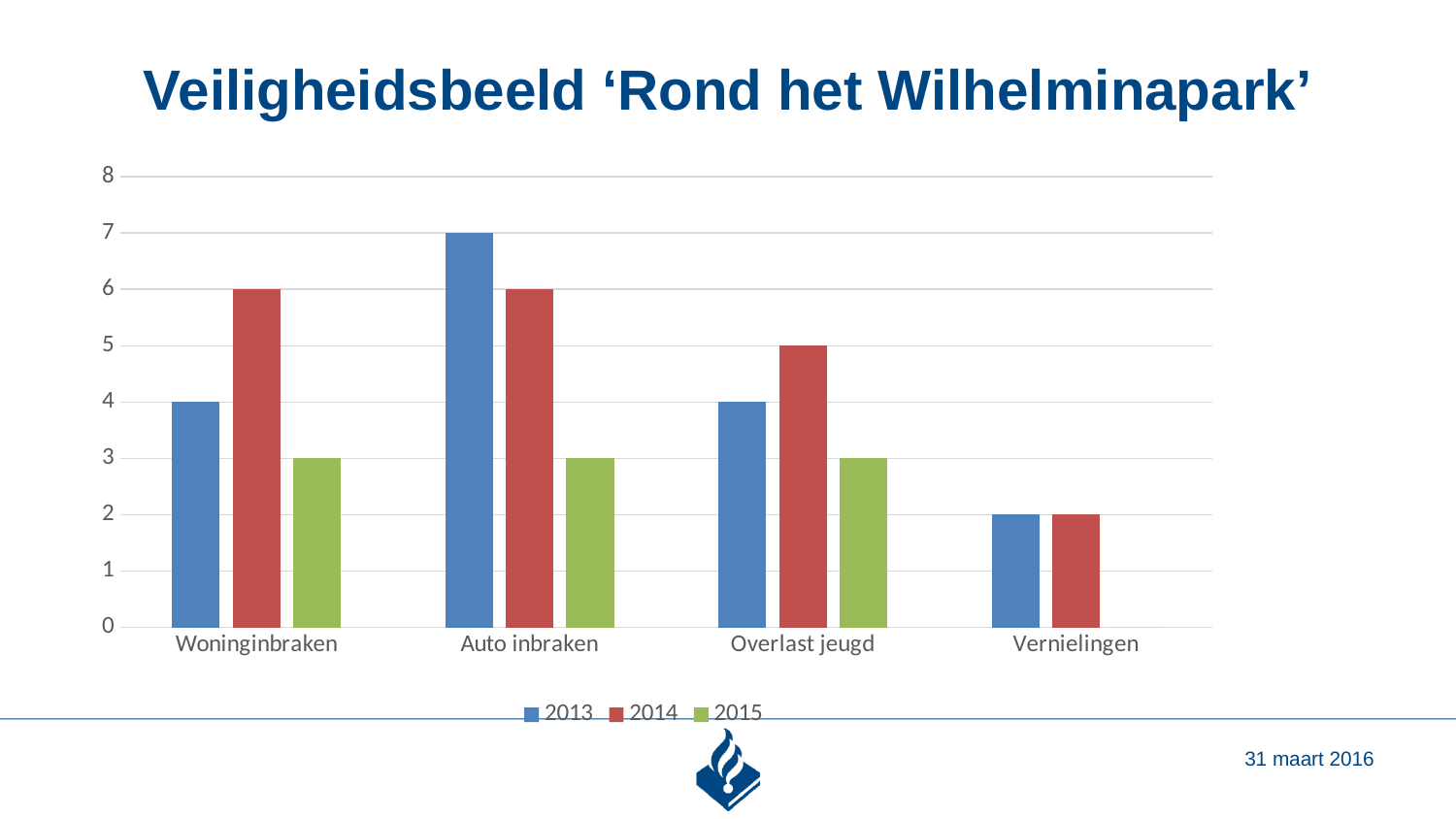
How many categories are shown on the x axis? 4 How many series does the legend list? 3 What is the difference between the 2013 and 2015 values for Auto inbraken? 4 What is the value for Overlast jeugd in 2015? 3 Which category has the highest value for 2013? Auto inbraken What is the value for Auto inbraken in 2013? 7 Which category has the lowest value for 2014? Vernielingen What type of chart is shown on the slide? bar chart What is the title of the chart? Veiligheidsbeeld ‘Rond het Wilhelminapark’ Which is larger for Overlast jeugd: the 2013 value or the 2014 value? 2014 What is the value for Vernielingen in 2014? 2 What is the value for Woninginbraken in 2014? 6